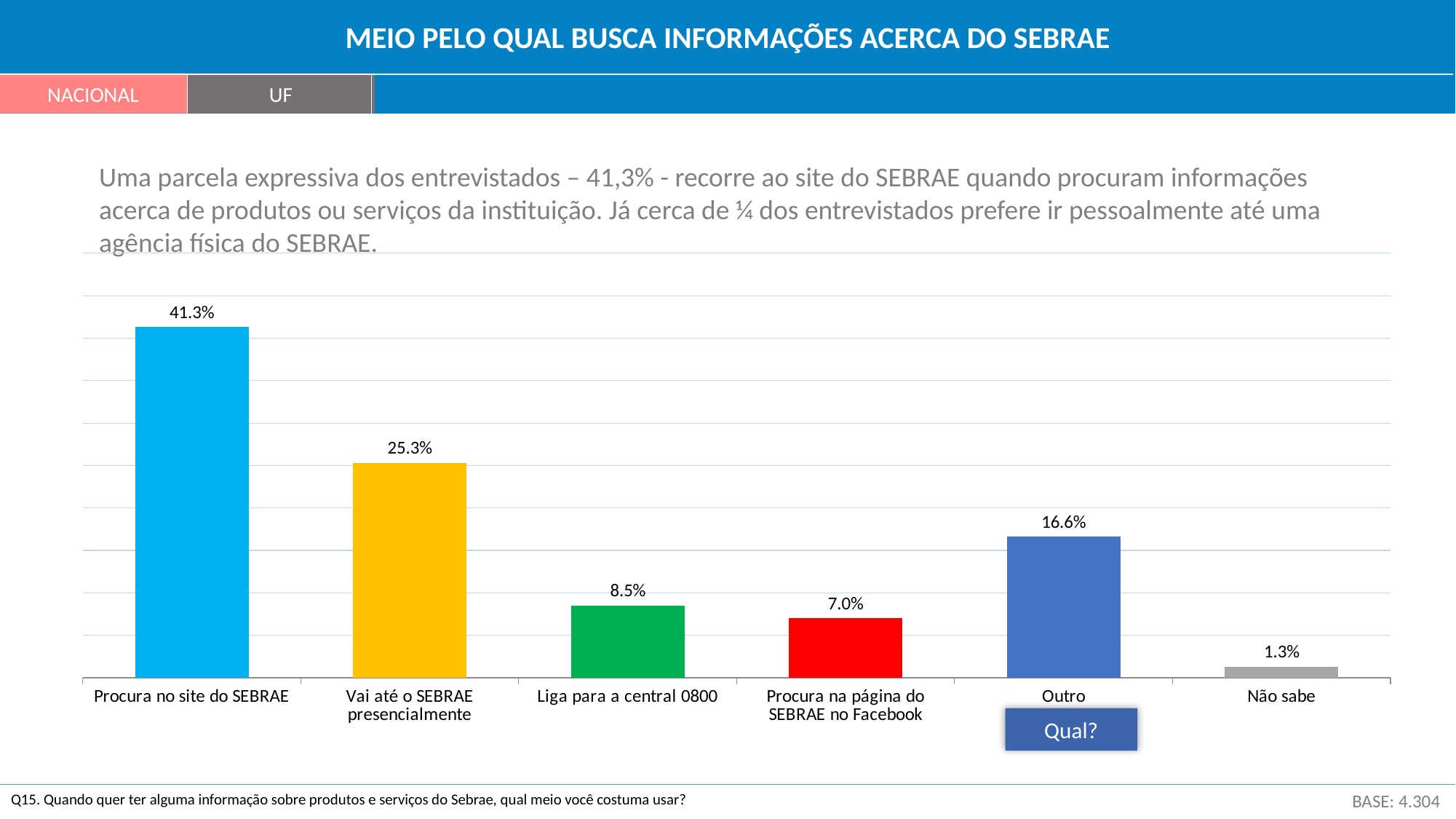
How many categories are shown in the chart? 6 What is the value for "Liga para a central 0800"? 8.5% Which is larger: "Outro" or "Liga para a central 0800"? Outro What is the title of the slide? MEIO PELO QUAL BUSCA INFORMAÇÕES ACERCA DO SEBRAE What kind of chart is shown on the slide? Bar chart What is the value for "Não sabe"? 1.3% Which category has the lowest value? Não sabe Which category has the highest value? Procura no site do SEBRAE What percentage of respondents search the SEBRAE website ("Procura no site do SEBRAE")? 41.3% What is the value for "Vai até o SEBRAE presencialmente"? 25.3% What is the value for "Procura na página do SEBRAE no Facebook"? 7.0% What is the difference between "Procura no site do SEBRAE" and "Vai até o SEBRAE presencialmente"? 16.0%